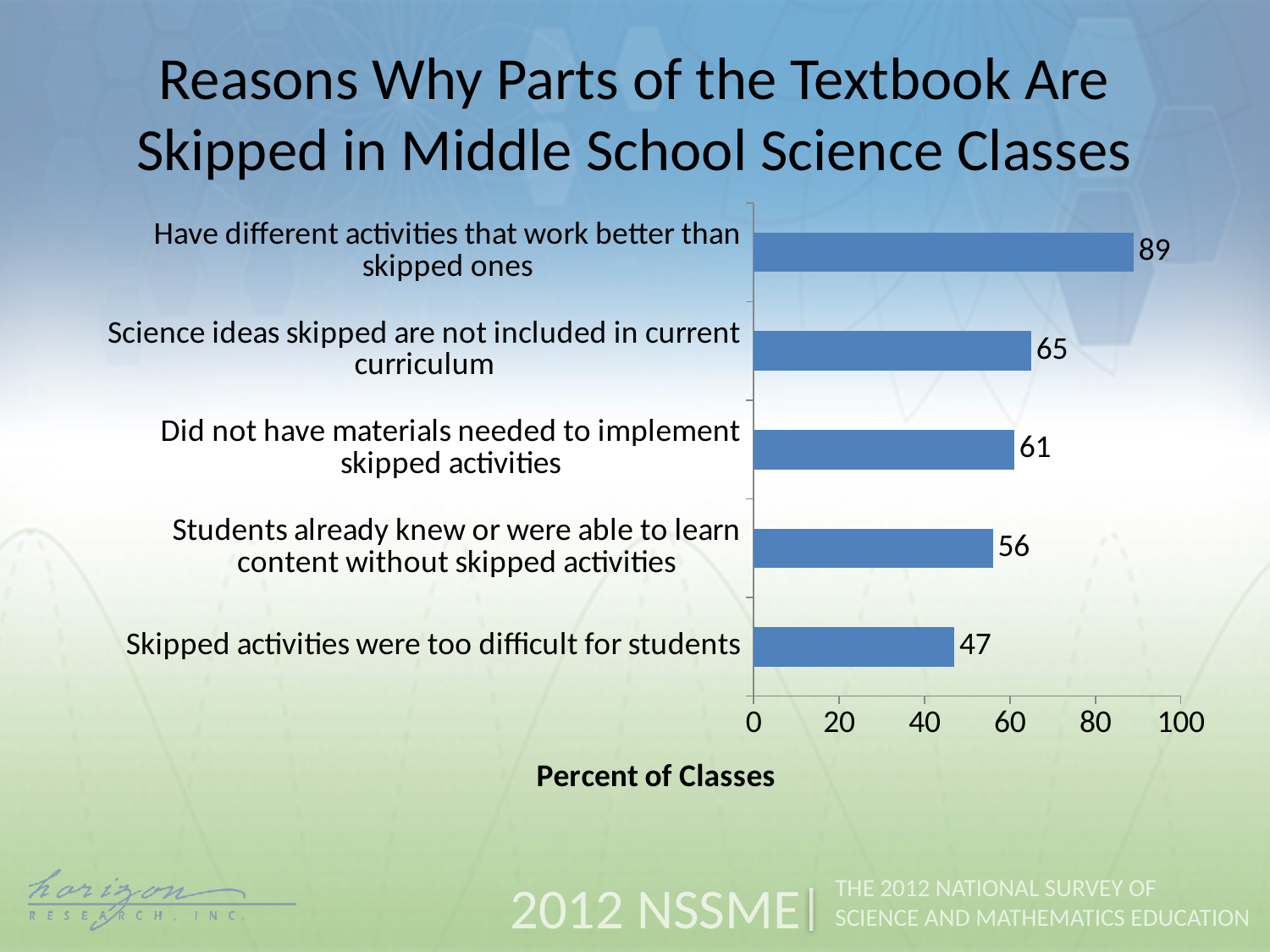
What is the difference between the values for 'Have different activities that work better than skipped ones' and 'Skipped activities were too difficult for students'? 42 Which reason has the lowest percent of classes? Skipped activities were too difficult for students How many reasons are shown in the chart? 5 What is the label of the horizontal axis? Percent of Classes Which is larger: the value for 'Students already knew or were able to learn content without skipped activities' or the value for 'Skipped activities were too difficult for students'? Students already knew or were able to learn content without skipped activities Which reason has the highest percent of classes? Have different activities that work better than skipped ones What is the value for 'Did not have materials needed to implement skipped activities'? 61 What kind of chart is shown on the slide? Bar chart What is the value for 'Skipped activities were too difficult for students'? 47 What percent of classes skipped parts of the textbook because they have different activities that work better than skipped ones? 89 What is the difference between the values for 'Science ideas skipped are not included in current curriculum' and 'Did not have materials needed to implement skipped activities'? 4 Is the value for 'Science ideas skipped are not included in current curriculum' greater or less than 60? greater